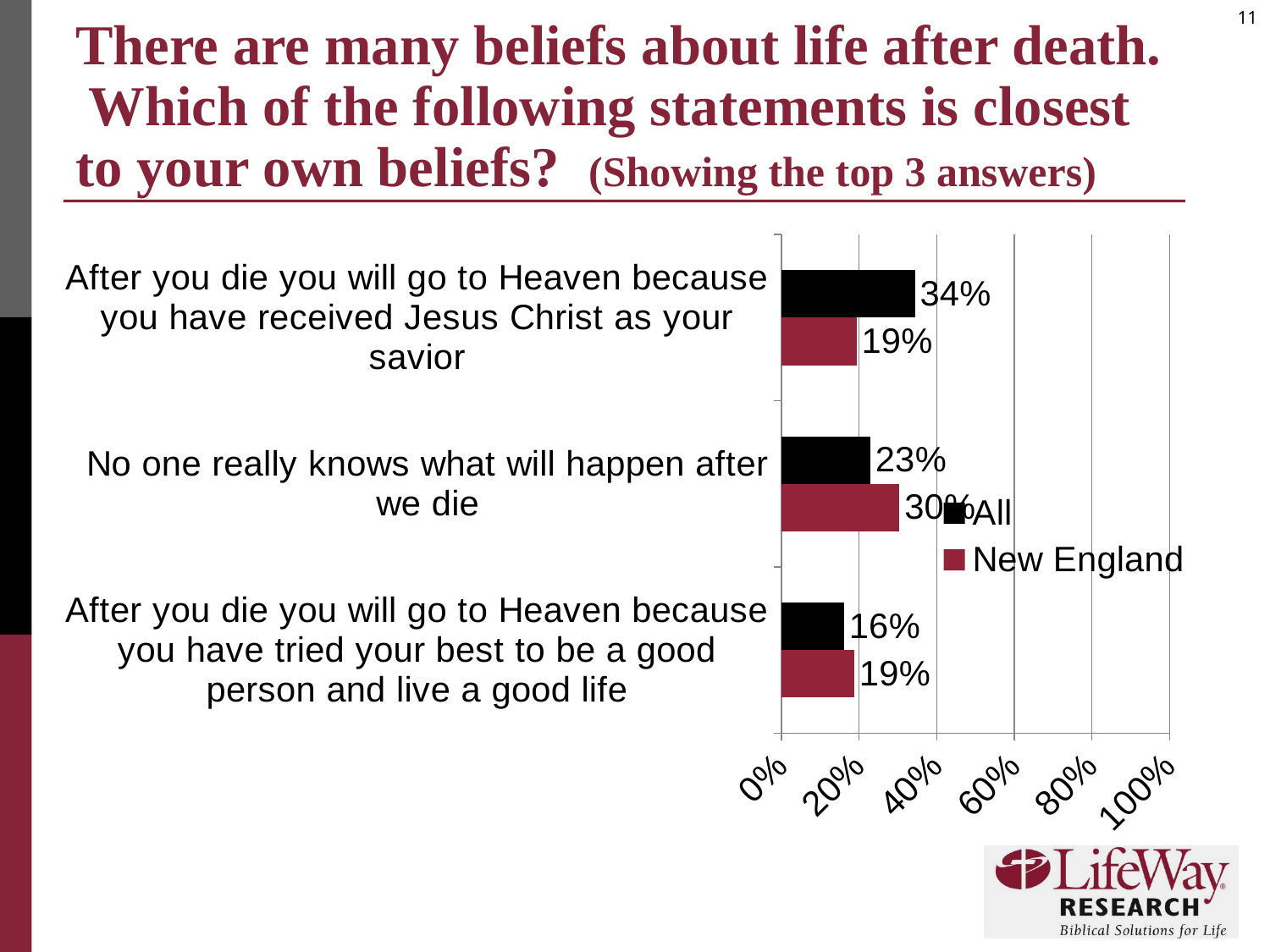
Is the All value for "After you die you will go to Heaven because you have received Jesus Christ as your savior" greater or less than 20%? greater What percentage of New England respondents chose "After you die you will go to Heaven because you have received Jesus Christ as your savior"? 19% Which statement has the lowest value for the All series? After you die you will go to Heaven because you have tried your best to be a good person and live a good life What percentage of All respondents chose "After you die you will go to Heaven because you have tried your best to be a good person and live a good life"? 16% Which statement has the highest value for the All series? After you die you will go to Heaven because you have received Jesus Christ as your savior How many series does the legend list? 2 How many statements (categories) are shown in the chart? 3 For "No one really knows what will happen after we die", which group has the larger value, All or New England? New England What is the difference between the All and New England values for "After you die you will go to Heaven because you have received Jesus Christ as your savior"? 15% What percentage of All respondents chose "After you die you will go to Heaven because you have received Jesus Christ as your savior"? 34% What type of chart is shown on the slide? Bar chart What percentage of All respondents chose "No one really knows what will happen after we die"? 23%